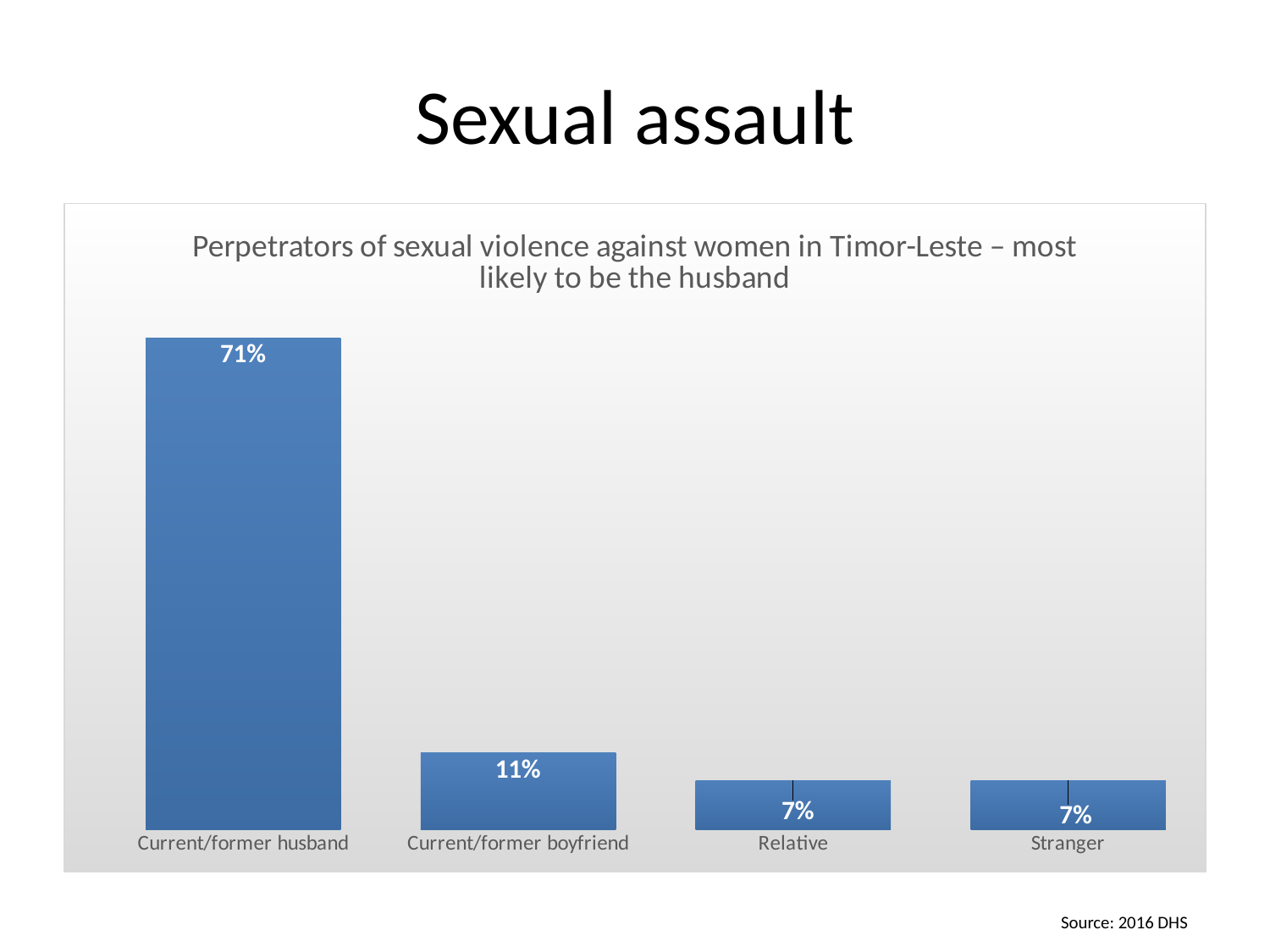
What is the title of the chart? Perpetrators of sexual violence against women in Timor-Leste – most likely to be the husband Which category has the highest value? Current/former husband What is the value for Relative? 7% What is the difference between the values for Current/former husband and Current/former boyfriend? 60% What is the difference between the values for Current/former boyfriend and Relative? 4% What kind of chart is shown on the slide? Bar chart What is the value for Current/former husband? 71% Do the values rise or fall from left to right across the categories? Fall What is the value for Stranger? 7% What is the value for Current/former boyfriend? 11% How many categories are shown in the chart? 4 Which is larger, the value for Current/former boyfriend or the value for Stranger? Current/former boyfriend